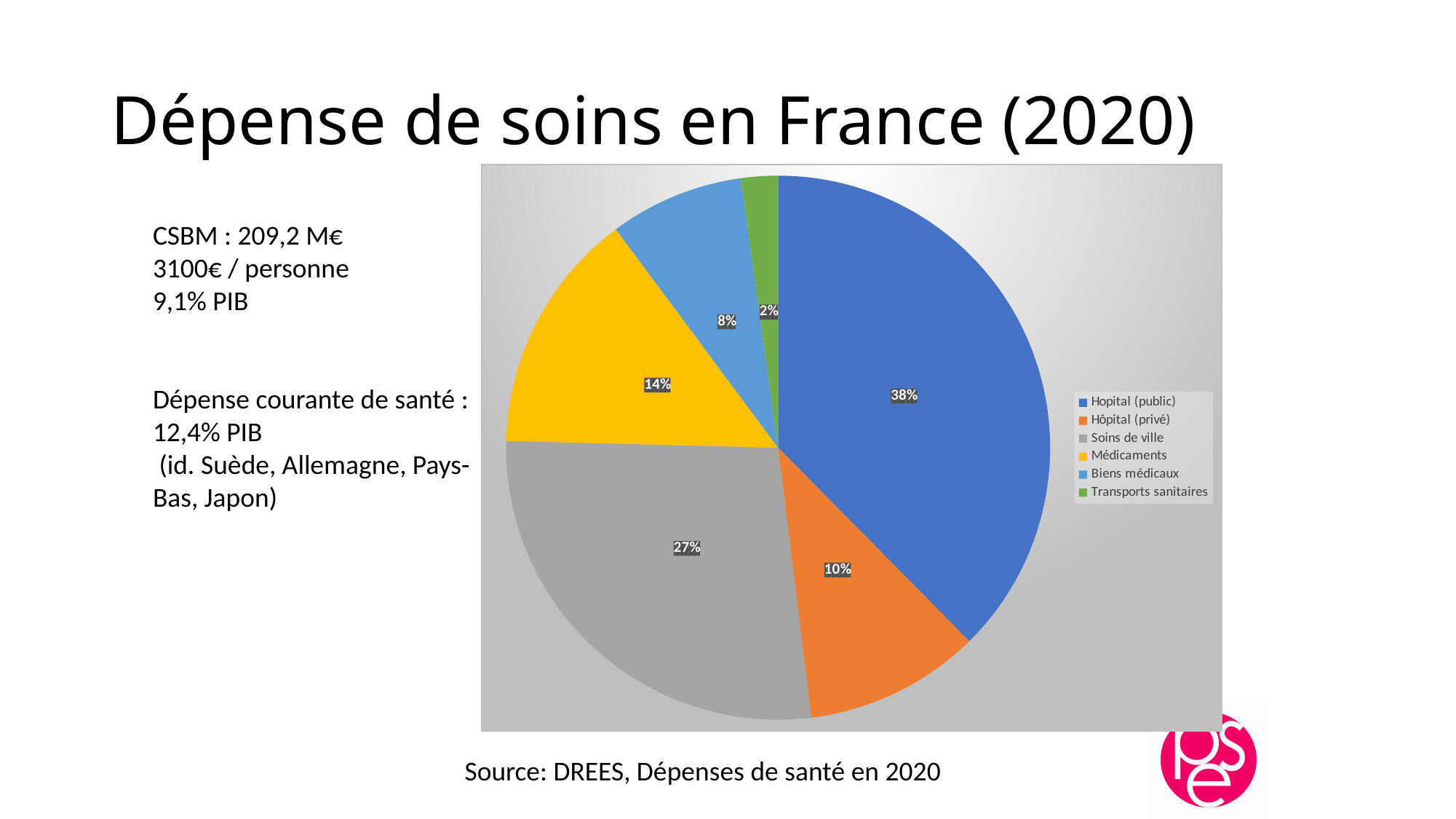
What share of the pie does Biens médicaux represent? 8% How many categories does the pie chart have? 6 Which category has the largest slice of the pie? Hopital (public) What is the difference in percentage points between Hopital (public) and Soins de ville? 11 Which colour represents Transports sanitaires in the legend? green Which category has the smallest slice of the pie? Transports sanitaires What kind of chart is shown on the slide? pie chart What share of the pie does Soins de ville represent? 27% What share of the pie does Médicaments represent? 14% Which is larger, the share for Médicaments or the share for Biens médicaux? Médicaments